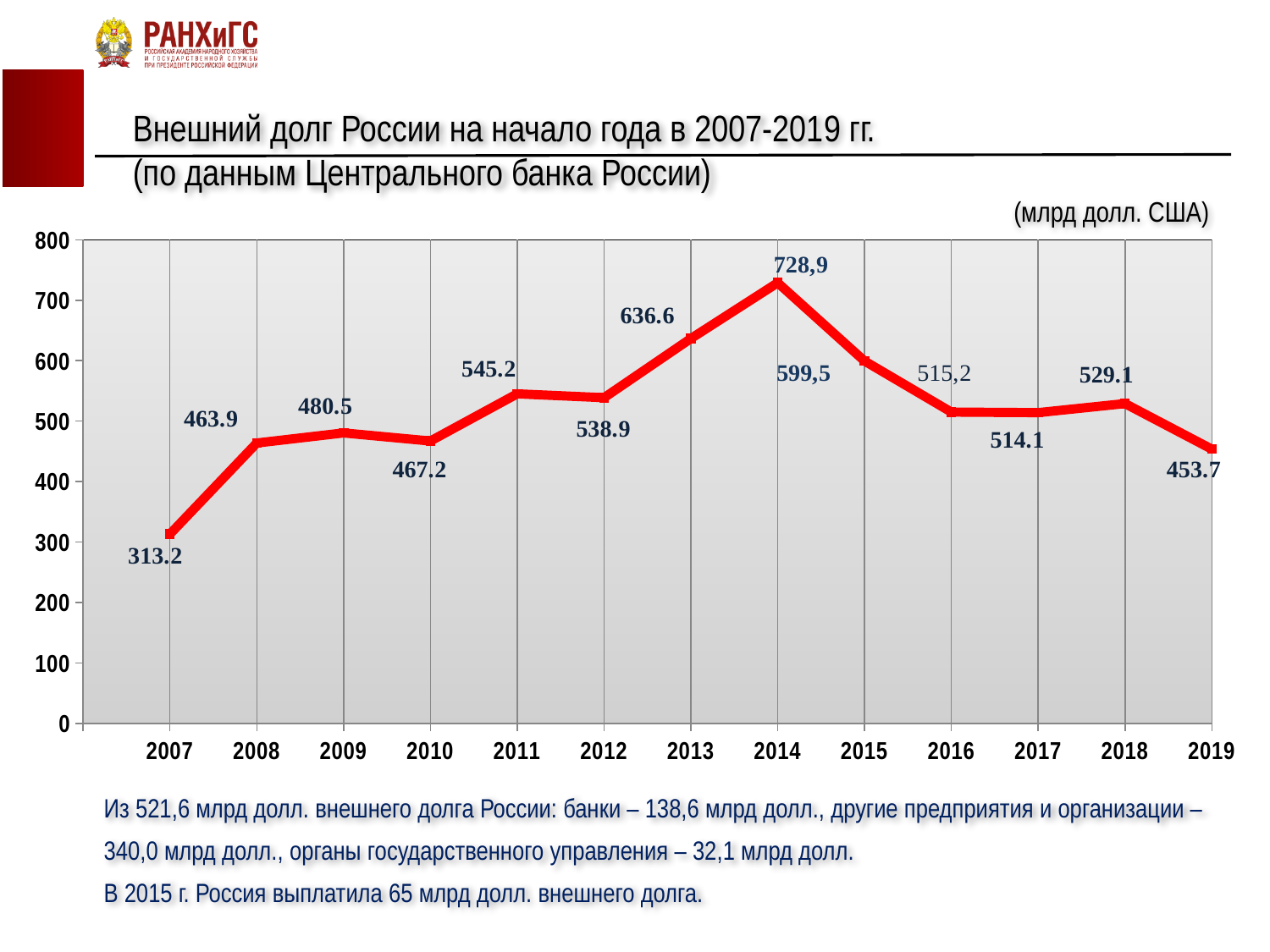
Which year has the highest value? 2014 What is the difference between the values for 2013 and 2012? 97.7 Do the values rise or fall from 2007 to 2014? rise What is the value for 2019? 453.7 Which is larger, the value for 2018 or the value for 2019? 2018 What is the value for 2007? 313.2 What is the value for 2014? 728,9 Which year has the lowest value? 2007 What is the difference between the values for 2008 and 2007? 150.7 What kind of chart is shown on the slide? line chart What is the value for 2011? 545.2 How many years are plotted on the chart? 13